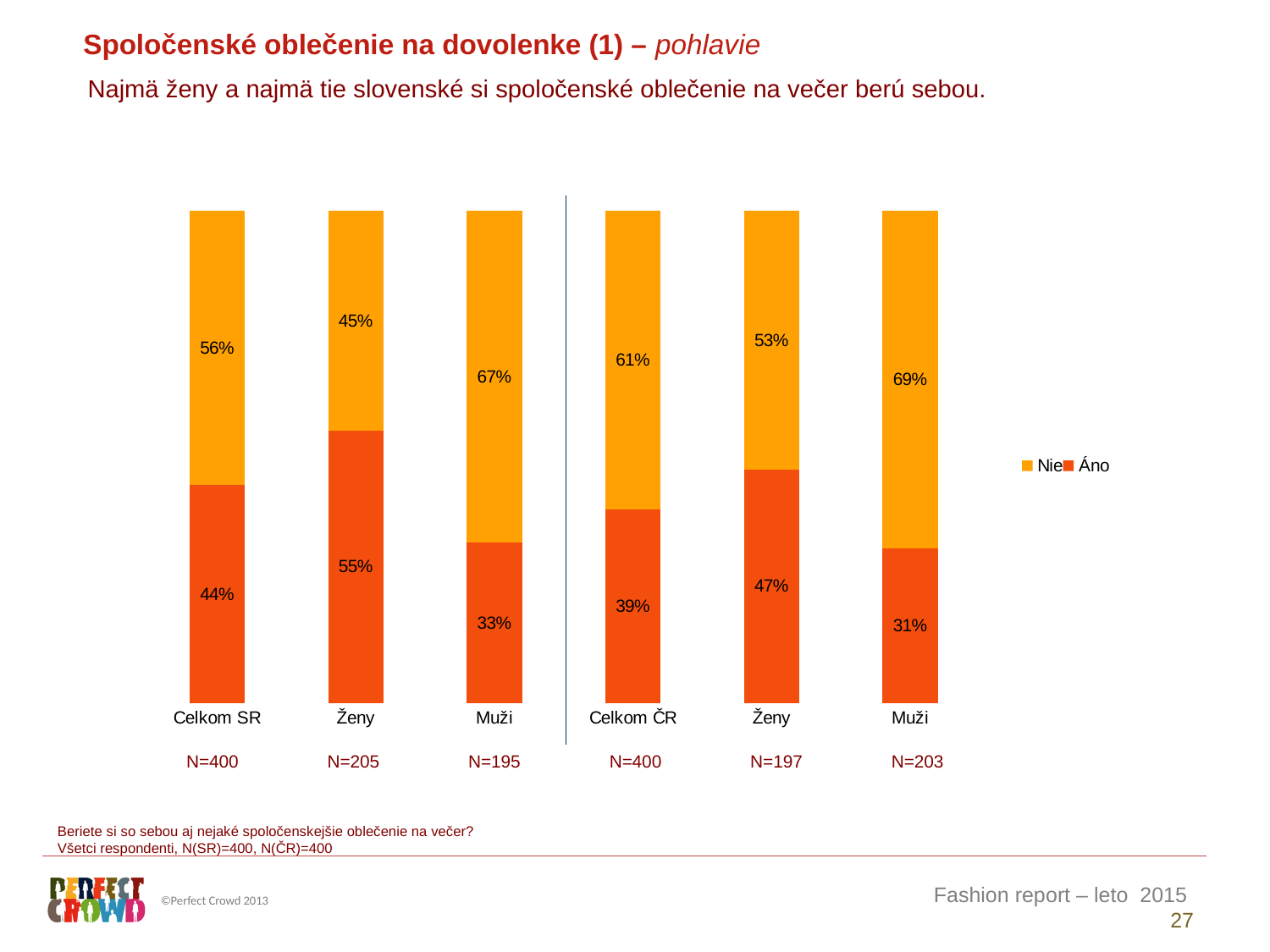
What is the "Nie" value for Muži in the ČR group (rightmost bar)? 69% What is the "Nie" value for Celkom ČR? 61% How many series does the legend list? 2 What is the difference between the "Áno" values for Celkom SR and Celkom ČR? 5 percentage points Which category has the lowest "Áno" value? Muži (ČR) What sample size (N) is shown under the Celkom ČR bar? N=400 Which category has the highest "Áno" value? Ženy (SR) Which is larger: the "Nie" value for Muži in the SR group or the "Nie" value for Muži in the ČR group? Muži (ČR) What is the "Áno" value for Ženy in the SR group (second bar from the left)? 55% What kind of chart is shown on the slide? stacked bar chart How many categories (bars) are plotted in the chart? 6 What is the "Áno" value for Celkom SR? 44%